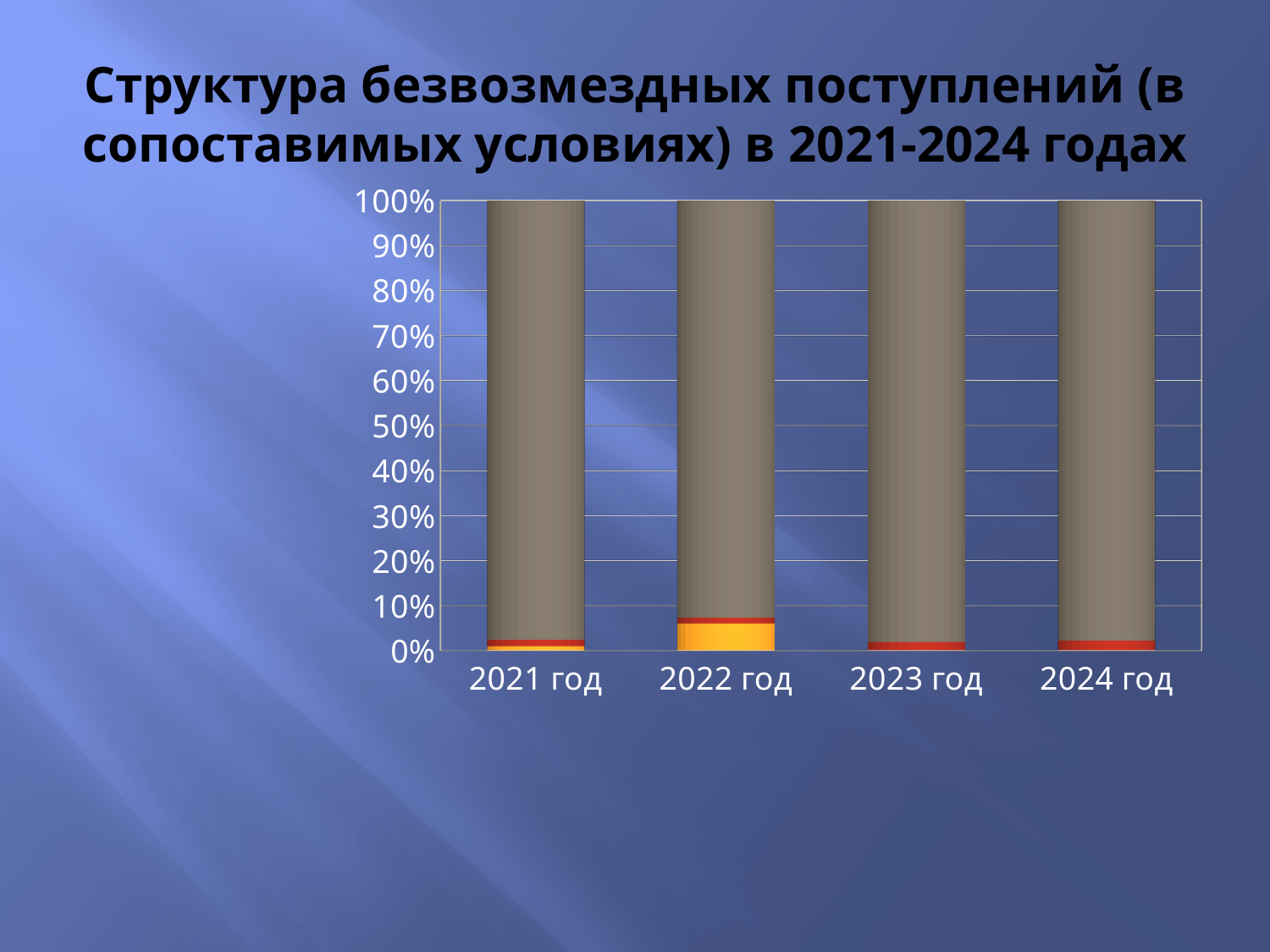
Is the share of the grey (top) segment for 2022 год greater or less than 90%? greater Is the share of the grey (top) segment for 2024 год greater or less than 90%? greater Is the share of the red segment for 2023 год greater or less than 10%? less What is the highest value shown on the y axis of the chart? 100% What is the first category label on the x axis? 2021 год In which year is the yellow segment the largest? 2022 год How many years (categories) are shown on the x axis of the chart? 4 Which is larger in 2022 год: the grey segment or the yellow segment? The grey segment What is the title of the chart on the slide? Структура безвозмездных поступлений (в сопоставимых условиях) в 2021-2024 годах What kind of chart is shown on the slide? Stacked bar chart